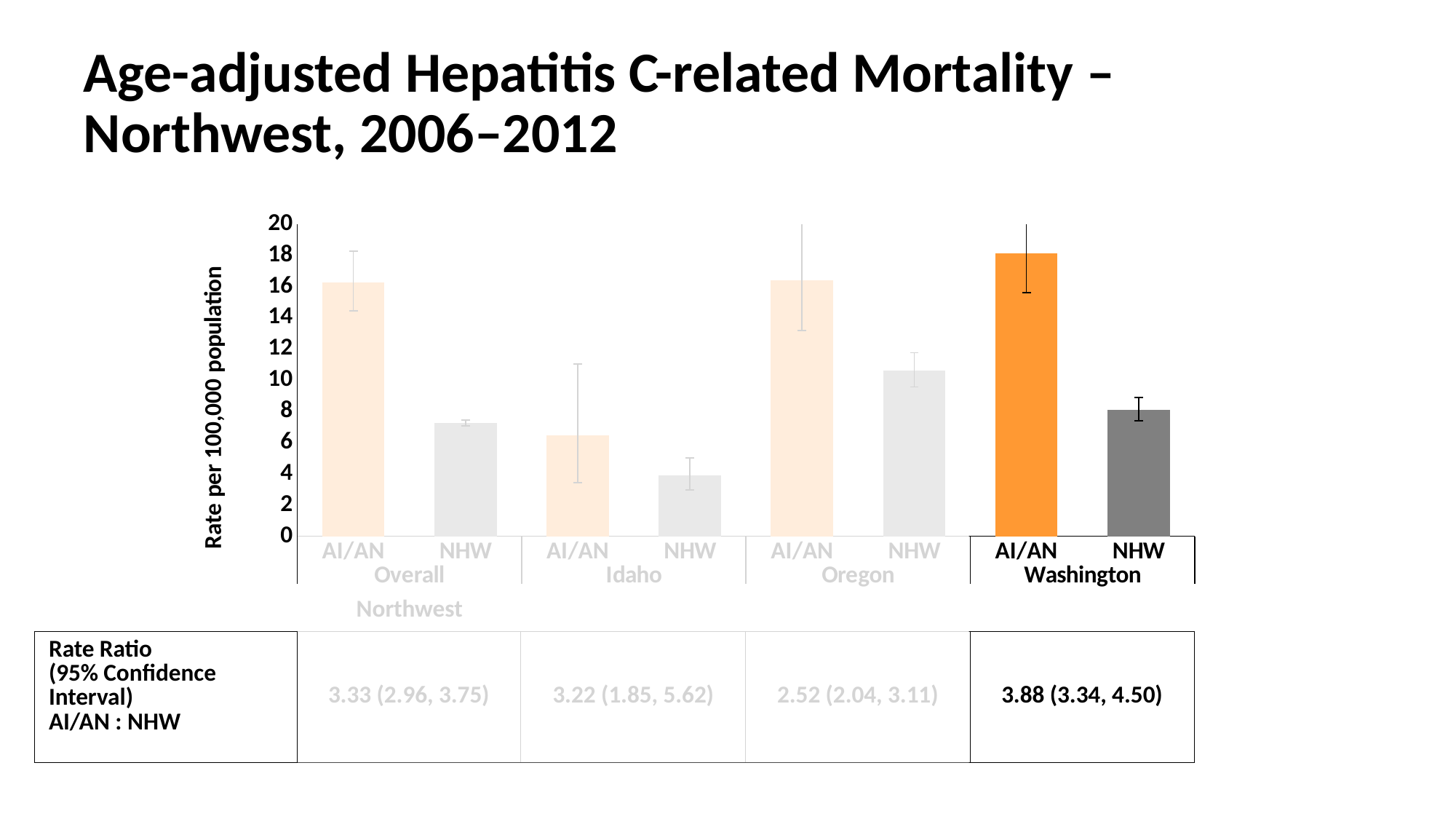
Is the value for AI/AN in Overall Northwest greater or less than 14? greater What kind of chart is shown on the slide? Bar chart Which bar is the highest in the chart? AI/AN in Washington How many bars are plotted in the chart? 8 Is the value for NHW in Idaho greater or less than 6? less What is the rate ratio (95% confidence interval) AI/AN : NHW shown for Washington? 3.88 (3.34, 4.50) Which bar is the lowest in the chart? NHW in Idaho How many region groups are shown along the x axis of the chart? 4 Is the value for NHW in Oregon greater or less than 12? less What is the label on the y axis of the chart? Rate per 100,000 population In Oregon, which is larger, the AI/AN bar or the NHW bar? AI/AN Which is larger, the AI/AN bar for Idaho or the NHW bar for Washington? NHW for Washington